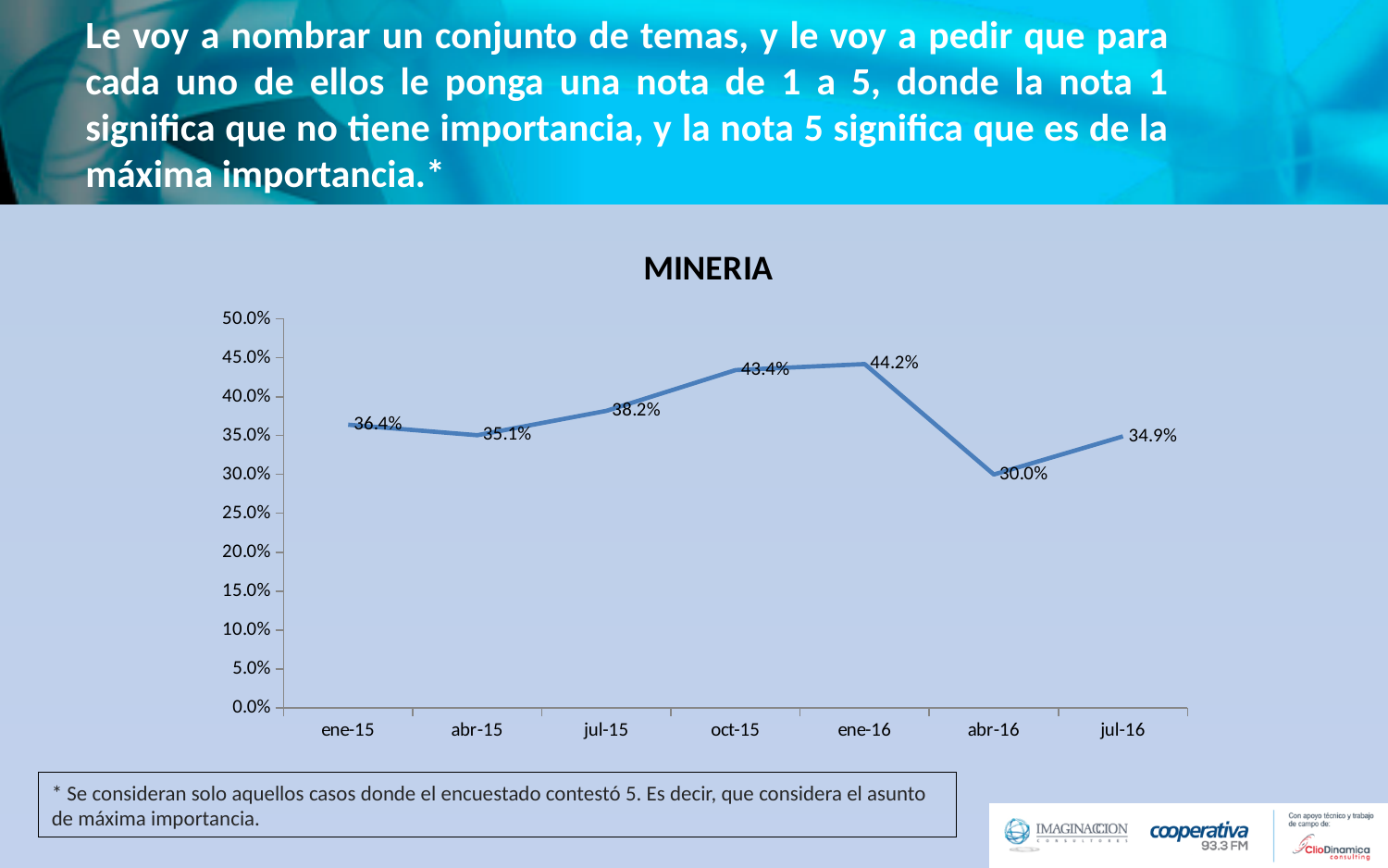
What is the difference between the values for ene-16 and abr-16 in the MINERIA chart? 14.2% Does the value in the MINERIA chart rise or fall from ene-16 to abr-16? fall Is the value for abr-15 in the MINERIA chart greater or less than 40.0%? less Which period has the lowest value in the MINERIA chart? abr-16 Which is larger in the MINERIA chart, the value for oct-15 or the value for jul-15? oct-15 How many data points are plotted in the MINERIA chart? 7 What is the value for ene-16 in the MINERIA chart? 44.2% What kind of chart is the MINERIA chart? line chart Which period has the highest value in the MINERIA chart? ene-16 What is the value for jul-16 in the MINERIA chart? 34.9% What is the value for ene-15 in the MINERIA chart? 36.4% What is the value for abr-16 in the MINERIA chart? 30.0%